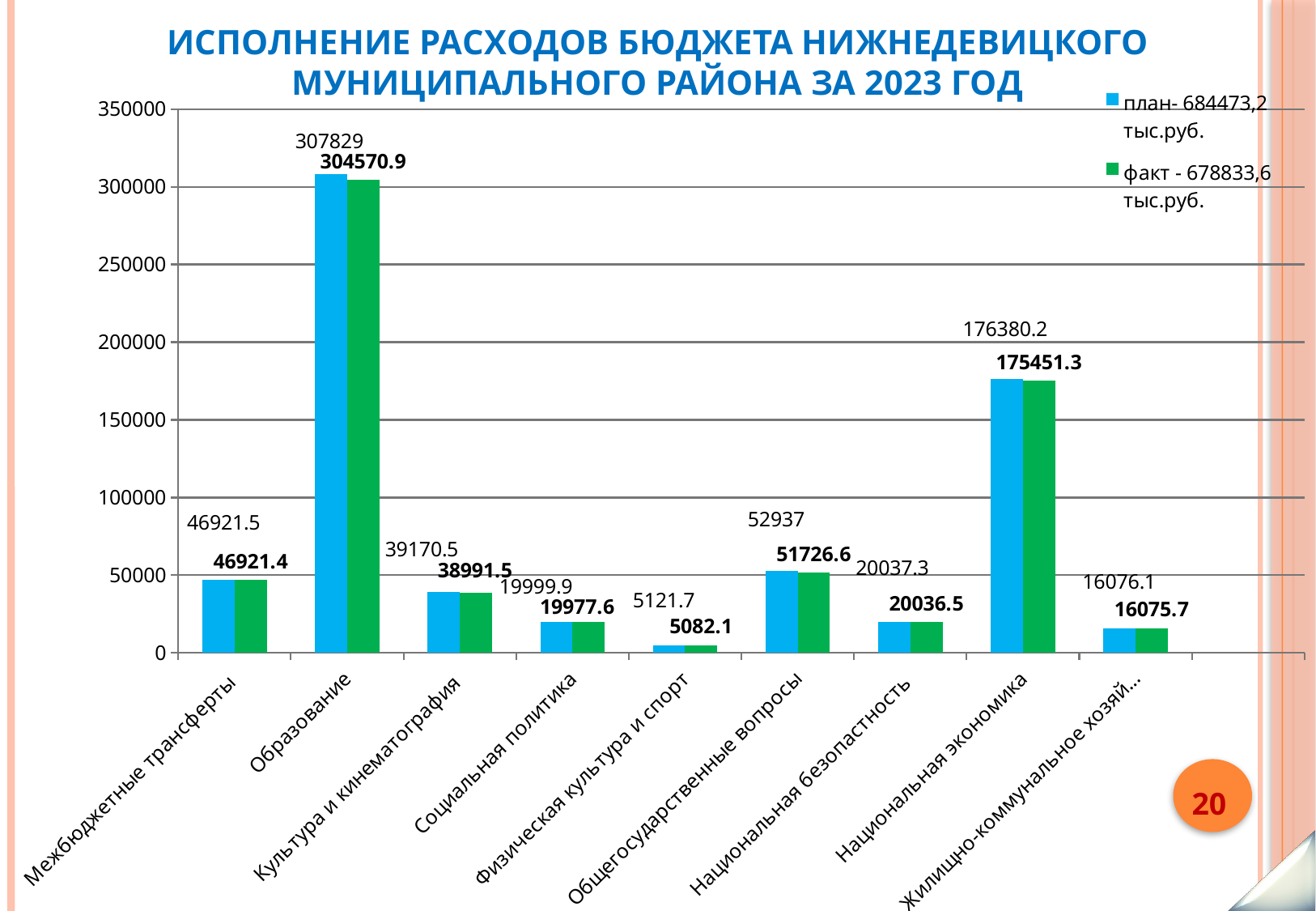
Which category has the lowest факт value? Физическая культура и спорт How many categories are shown on the x axis? 9 What is the факт value for Национальная экономика? 175451.3 What is the факт value for Физическая культура и спорт? 5082.1 How many series does the legend list? 2 Which category has the highest план value? Образование What is the difference between the план and факт values for Образование? 3258.1 What type of chart is shown on the slide? bar chart What total факт amount is stated in the legend? 678833,6 тыс.руб. What is the план value for Образование? 307829 What is the план value for Общегосударственные вопросы? 52937 Which is larger: the план value for Общегосударственные вопросы or the план value for Межбюджетные трансферты? Общегосударственные вопросы